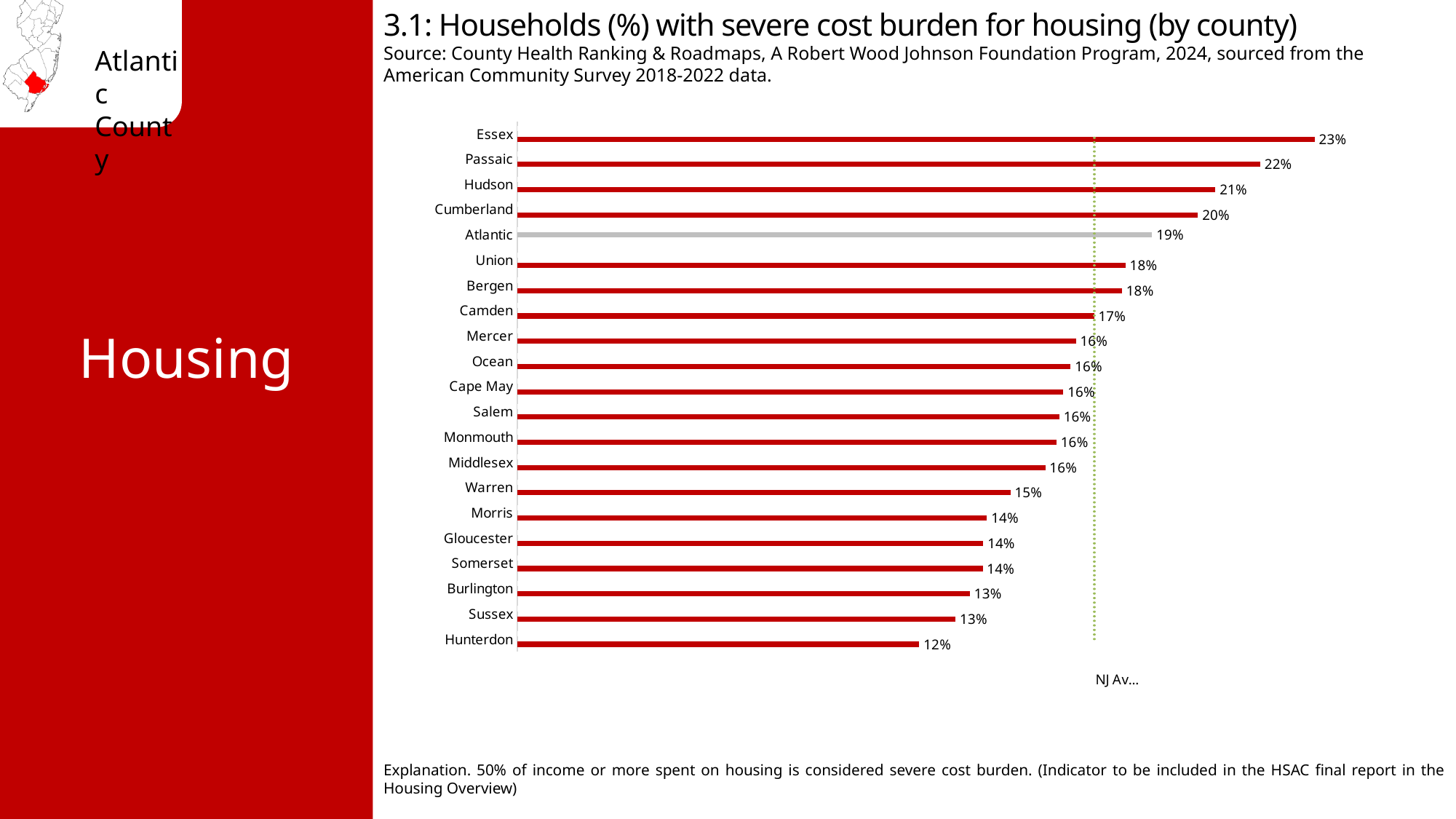
Which county has the highest percentage of households with severe cost burden for housing? Essex How many counties are shown in the chart? 21 Which county has the lowest percentage of households with severe cost burden for housing? Hunterdon What is the difference between the values for Essex and Hunterdon? 11 percentage points What is the value for Warren county? 15% What is the value for Cumberland county? 20% What is the value for Atlantic county? 19% Which county's bar is coloured grey instead of red? Atlantic What is the difference between the values for Passaic and Atlantic? 3 percentage points What is the title of the chart? 3.1: Households (%) with severe cost burden for housing (by county) Which has a higher value, Hudson or Camden? Hudson What kind of chart is shown on the slide? bar chart